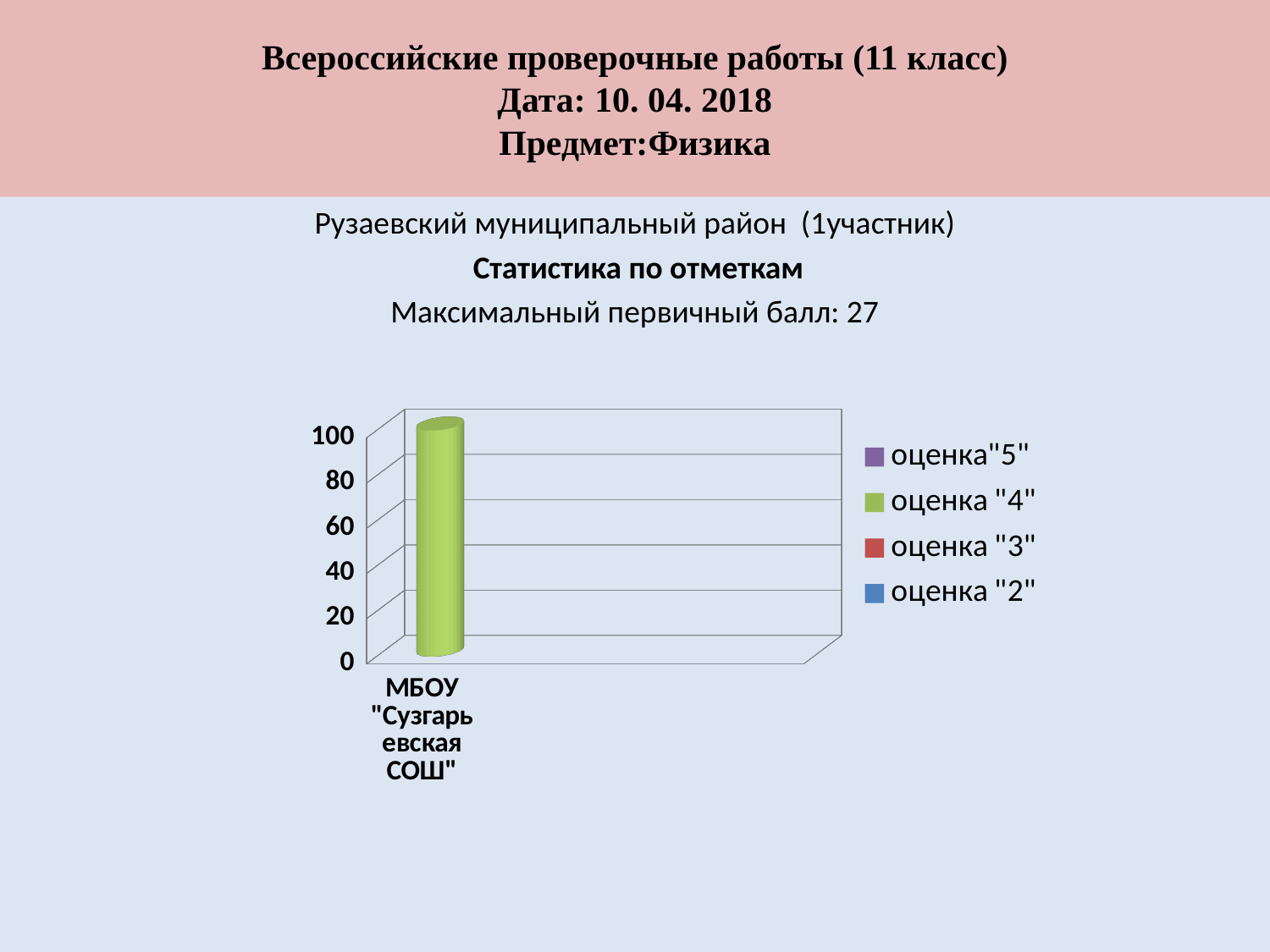
Which series is listed first in the chart legend? оценка"5" How many series does the chart legend list? 4 Which series has a visible bar for МБОУ "Сузгарьевская СОШ"? оценка "4" What kind of chart is shown on the slide? bar chart Is the value of оценка "4" for МБОУ "Сузгарьевская СОШ" greater or less than 80? greater Is the value of оценка "4" for МБОУ "Сузгарьевская СОШ" greater or less than 60? greater How many categories are shown on the x axis of the chart? 1 Which category is shown on the x axis of the chart? МБОУ "Сузгарьевская СОШ" What is the highest value shown on the vertical axis of the chart? 100